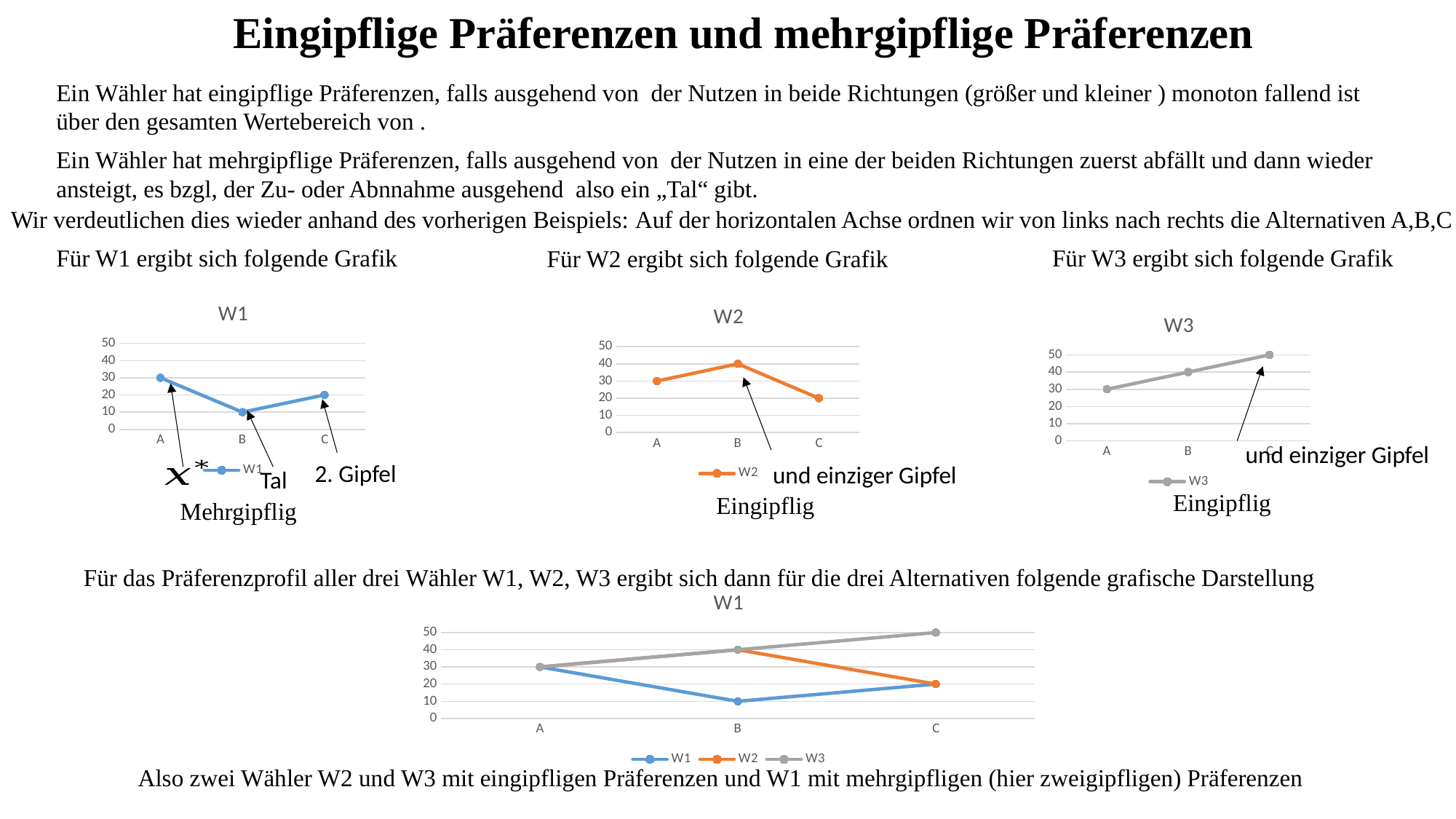
How many series does the legend of the bottom chart list? 3 In the top-middle chart titled W2, which category has the highest value? B In the top-right chart titled W3, what is the value for C? 50 In the top-left chart titled W1, which category has the lowest value? B In the top-middle chart titled W2, what is the value for B? 40 In the top-left chart titled W1, what is the difference between the values for A and B? 20 How many categories are shown on the x axis of the bottom chart? 3 In the top-left chart titled W1, what is the value for B? 10 In the bottom chart, what is the value of the W3 series at B? 40 What kind of chart is the bottom chart? line chart In the top-right chart titled W3, do the values rise or fall from A to C? rise In the top-middle chart titled W2, which is larger, the value for A or the value for C? A